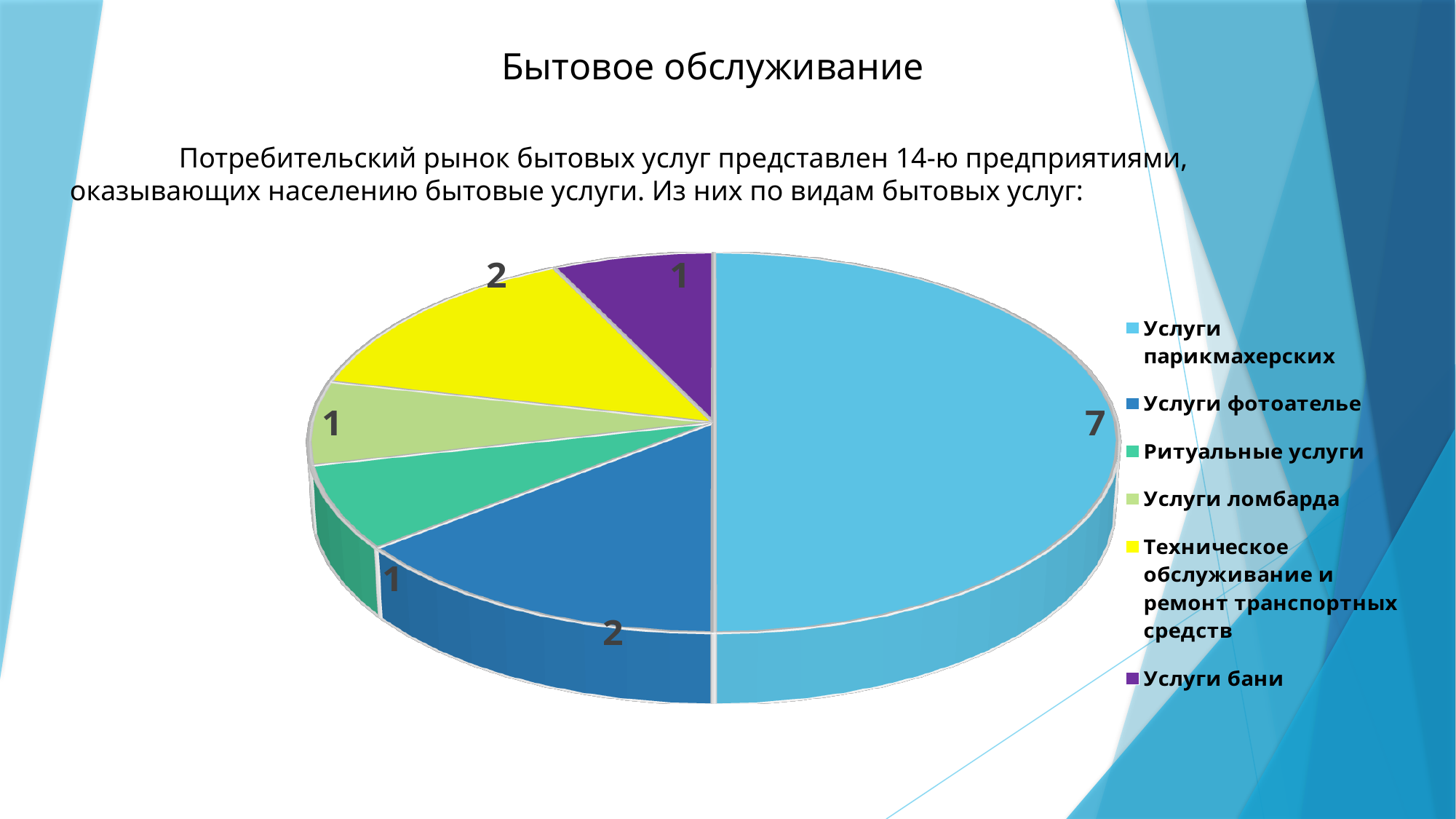
How many categories (slices) does the pie chart have? 6 What is the total of all the values in the pie chart? 14 Which is larger, the value for Ритуальные услуги or the value for Услуги фотоателье? Услуги фотоателье What is the value for Услуги фотоателье? 2 What is the difference between the values for Услуги парикмахерских and Услуги фотоателье? 5 Which category has the highest value in the pie chart? Услуги парикмахерских What share of the pie does Услуги парикмахерских represent? 50% What is the value for Услуги парикмахерских? 7 What kind of chart is shown on the slide? Pie chart What colour is the slice for Услуги бани? Purple What is the value for Услуги бани? 1 What is the value for Техническое обслуживание и ремонт транспортных средств? 2